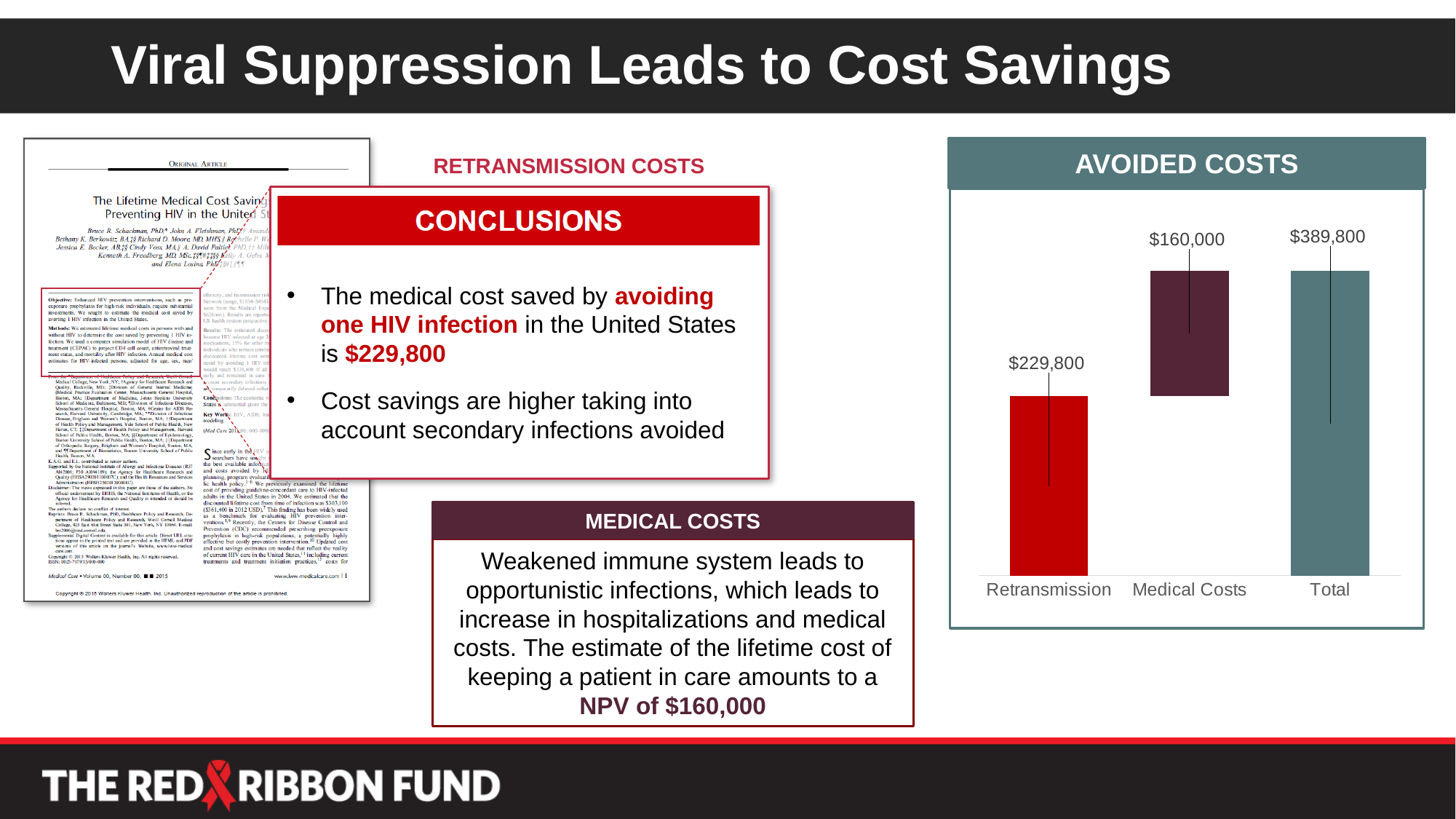
In the AVOIDED COSTS chart, which is larger: Retransmission or Medical Costs? Retransmission Which category has the highest value in the AVOIDED COSTS chart? Total How many categories are shown on the x axis of the AVOIDED COSTS chart? 3 What kind of chart is shown under the title AVOIDED COSTS? bar chart What is the value shown for Medical Costs in the AVOIDED COSTS chart? $160,000 What is the difference between the Retransmission and Medical Costs values in the AVOIDED COSTS chart? $69,800 What is the title of the chart on the slide? AVOIDED COSTS What colour is the Retransmission bar in the AVOIDED COSTS chart? red Which category has the lowest value in the AVOIDED COSTS chart? Medical Costs What is the value shown for Total in the AVOIDED COSTS chart? $389,800 What is the sum of the Retransmission and Medical Costs values in the AVOIDED COSTS chart? $389,800 What is the value shown for Retransmission in the AVOIDED COSTS chart? $229,800